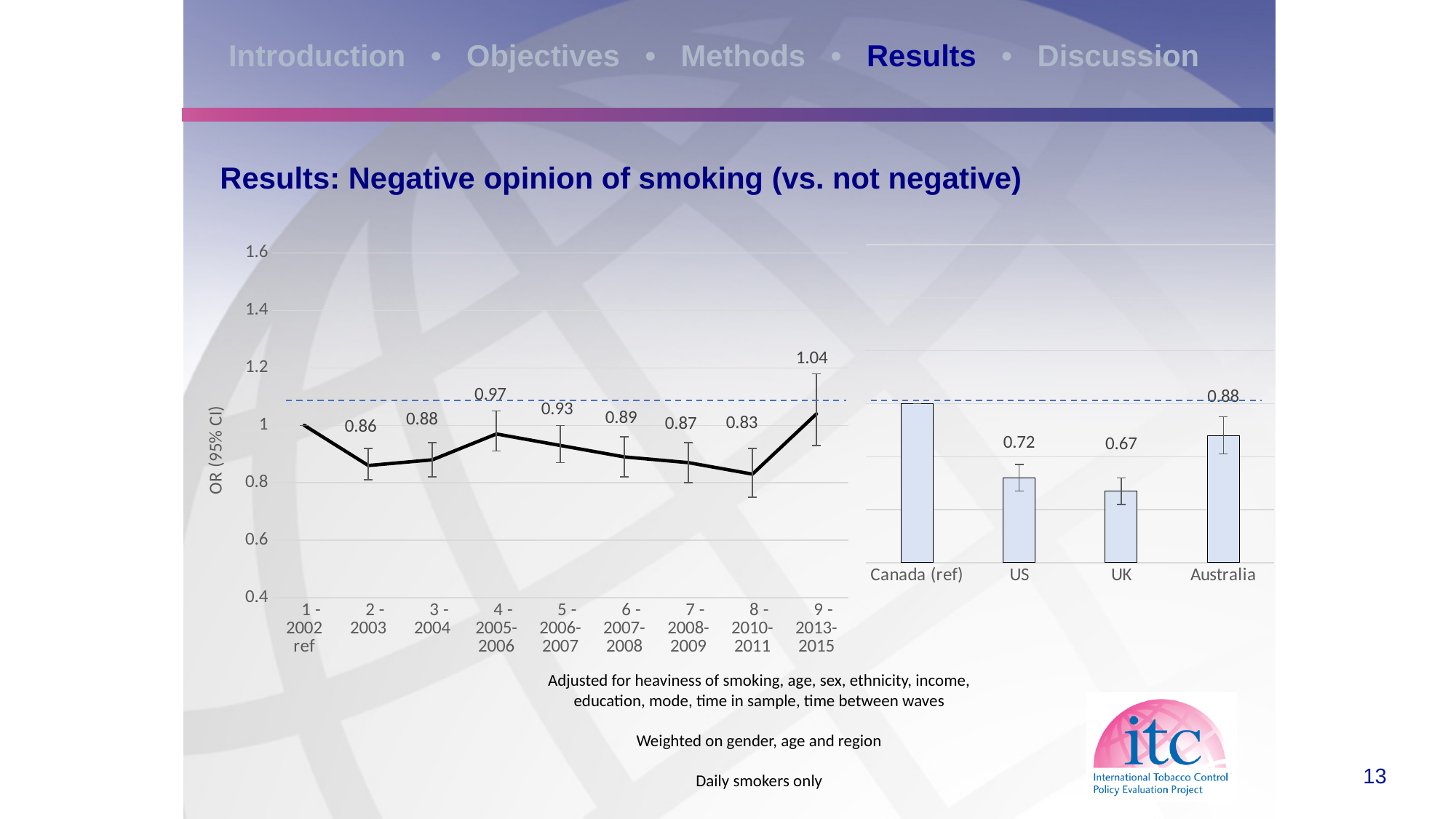
In the line chart on the left, how many waves are plotted along the x axis? 9 What is the label on the vertical axis of the line chart on the left? OR (95% CI) In the line chart on the left, what is the difference between the odds ratios for wave 9 (2013-2015) and wave 8 (2010-2011)? 0.21 In the line chart on the left, which wave has the lowest odds ratio? 8 - 2010-2011 In the bar chart on the right, which country has the lowest odds ratio? UK In the line chart on the left, which wave has the highest odds ratio? 9 - 2013-2015 What kind of chart is shown on the right side of the slide? Bar chart In the bar chart on the right, what is the difference between the odds ratios for Australia and the UK? 0.21 In the line chart on the left, what is the odds ratio for wave 9 (2013-2015)? 1.04 In the bar chart on the right, what is the odds ratio for the US? 0.72 In the line chart on the left, what is the odds ratio for wave 2 (2003)? 0.86 In the line chart on the left, which has the larger odds ratio: wave 4 (2005-2006) or wave 5 (2006-2007)? 4 - 2005-2006